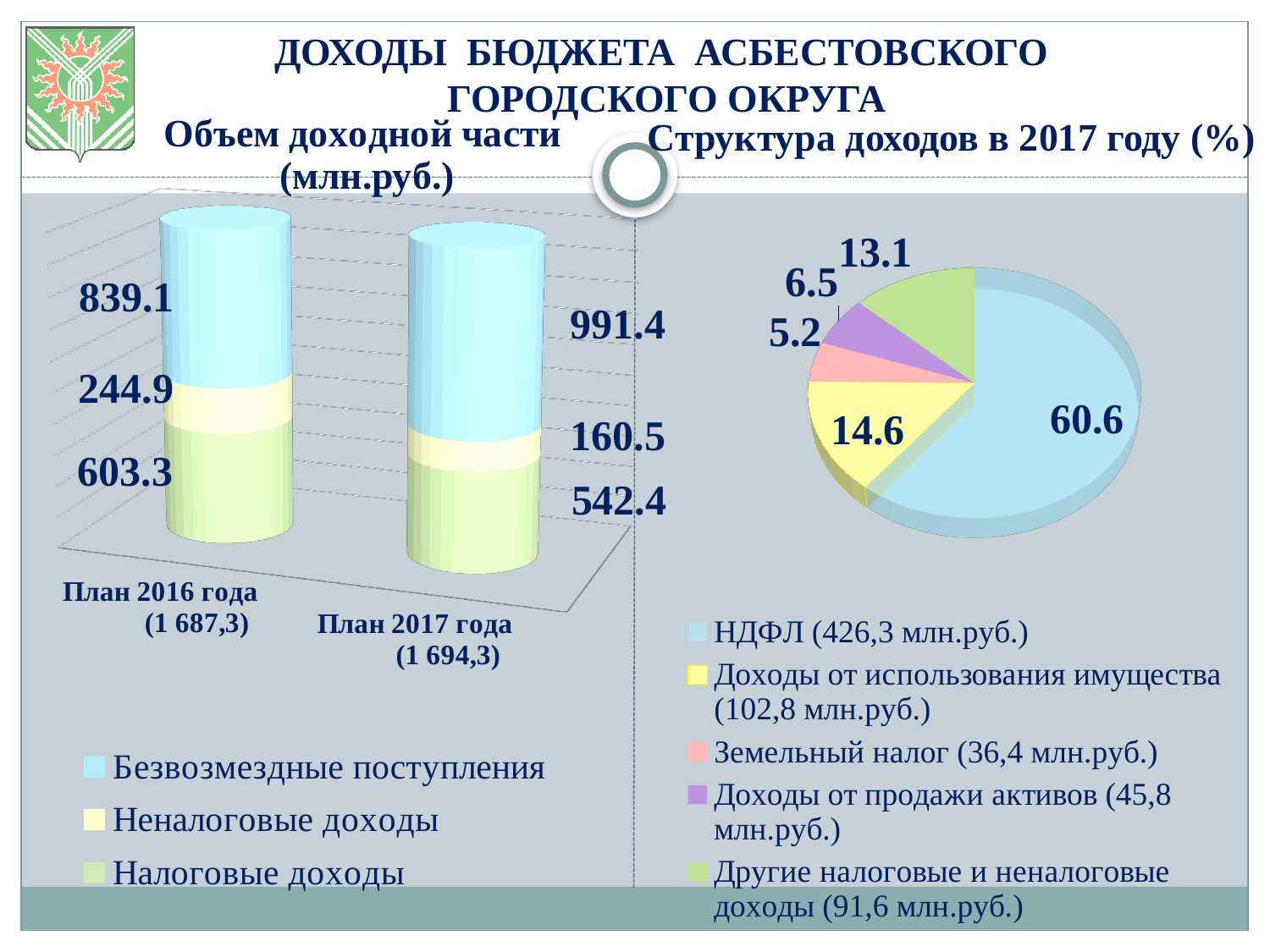
In the pie chart 'Структура доходов в 2017 году (%)', what is the share of Доходы от использования имущества? 14.6 In the chart 'Объем доходной части (млн.руб.)', which is larger: Налоговые доходы for План 2016 года or for План 2017 года? План 2016 года In the pie chart 'Структура доходов в 2017 году (%)', which category has the smallest share? Земельный налог In the chart 'Объем доходной части (млн.руб.)', what is the difference between Безвозмездные поступления in План 2017 года and in План 2016 года? 152.3 How many series does the legend of the chart 'Объем доходной части (млн.руб.)' list? 3 In the chart 'Объем доходной части (млн.руб.)', what is the value of Безвозмездные поступления for План 2017 года? 991.4 How many slices does the pie chart 'Структура доходов в 2017 году (%)' have? 5 In the chart 'Объем доходной части (млн.руб.)', what is the value of Неналоговые доходы for План 2017 года? 160.5 What kind of chart is 'Объем доходной части (млн.руб.)'? Stacked bar chart In the chart 'Объем доходной части (млн.руб.)', what is the total of the stacked bar for План 2016 года? 1 687,3 In the pie chart 'Структура доходов в 2017 году (%)', what share does НДФЛ have? 60.6 In the chart 'Объем доходной части (млн.руб.)', what is the value of Налоговые доходы for План 2016 года? 603.3